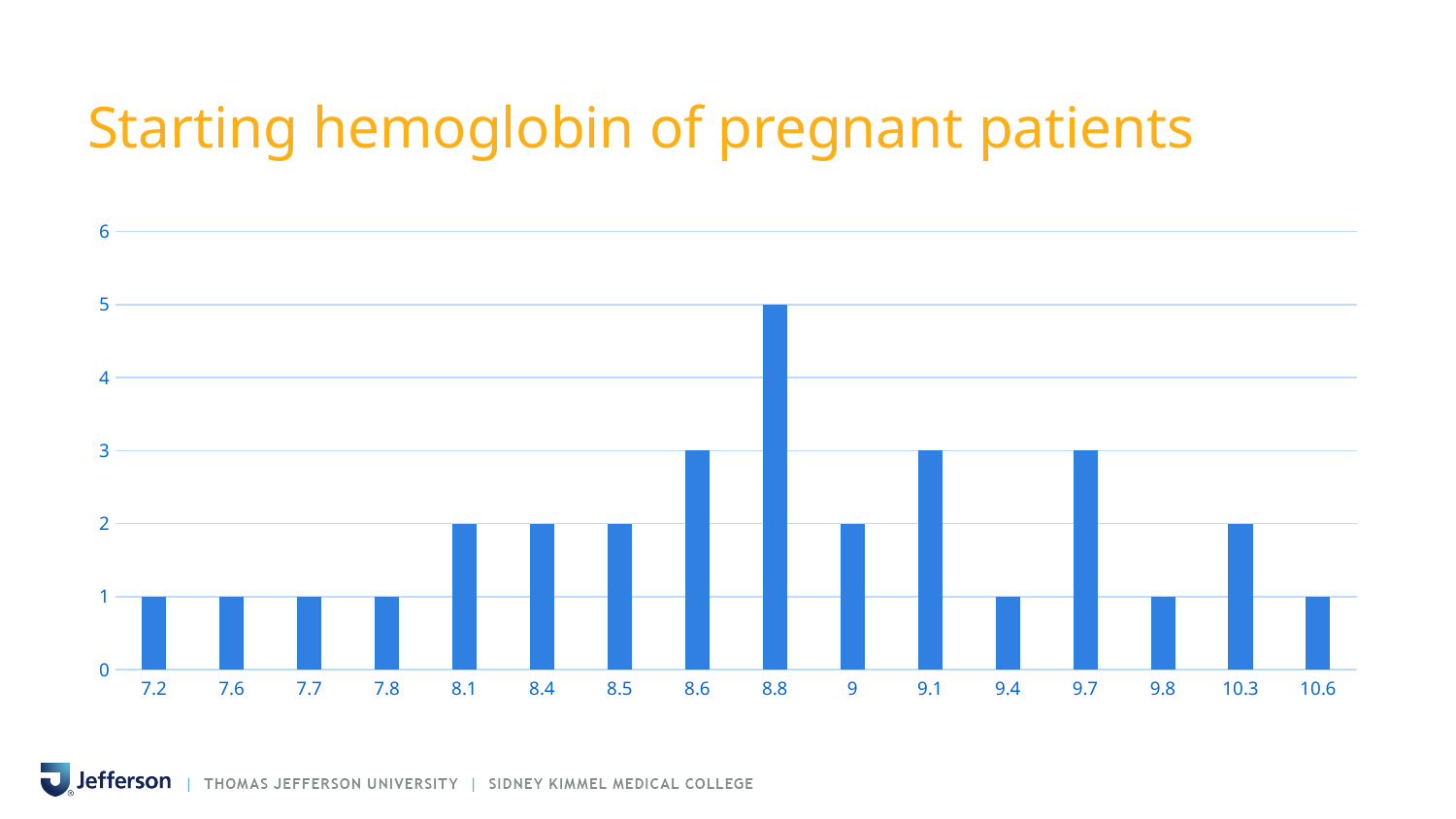
What is the value for 8.6? 3 Is the value for 8.8 greater or less than 4? greater Which is larger, the value for 9.1 or the value for 9.4? 9.1 What is the value for 8.8? 5 What is the title of the chart? Starting hemoglobin of pregnant patients How many categories are shown on the x axis? 16 Which category has the highest bar? 8.8 What is the value for 7.2? 1 What kind of chart is shown on the slide? bar chart What is the value for 10.3? 2 What is the difference between the values for 9.7 and 9.8? 2 What is the difference between the values for 8.8 and 9? 3